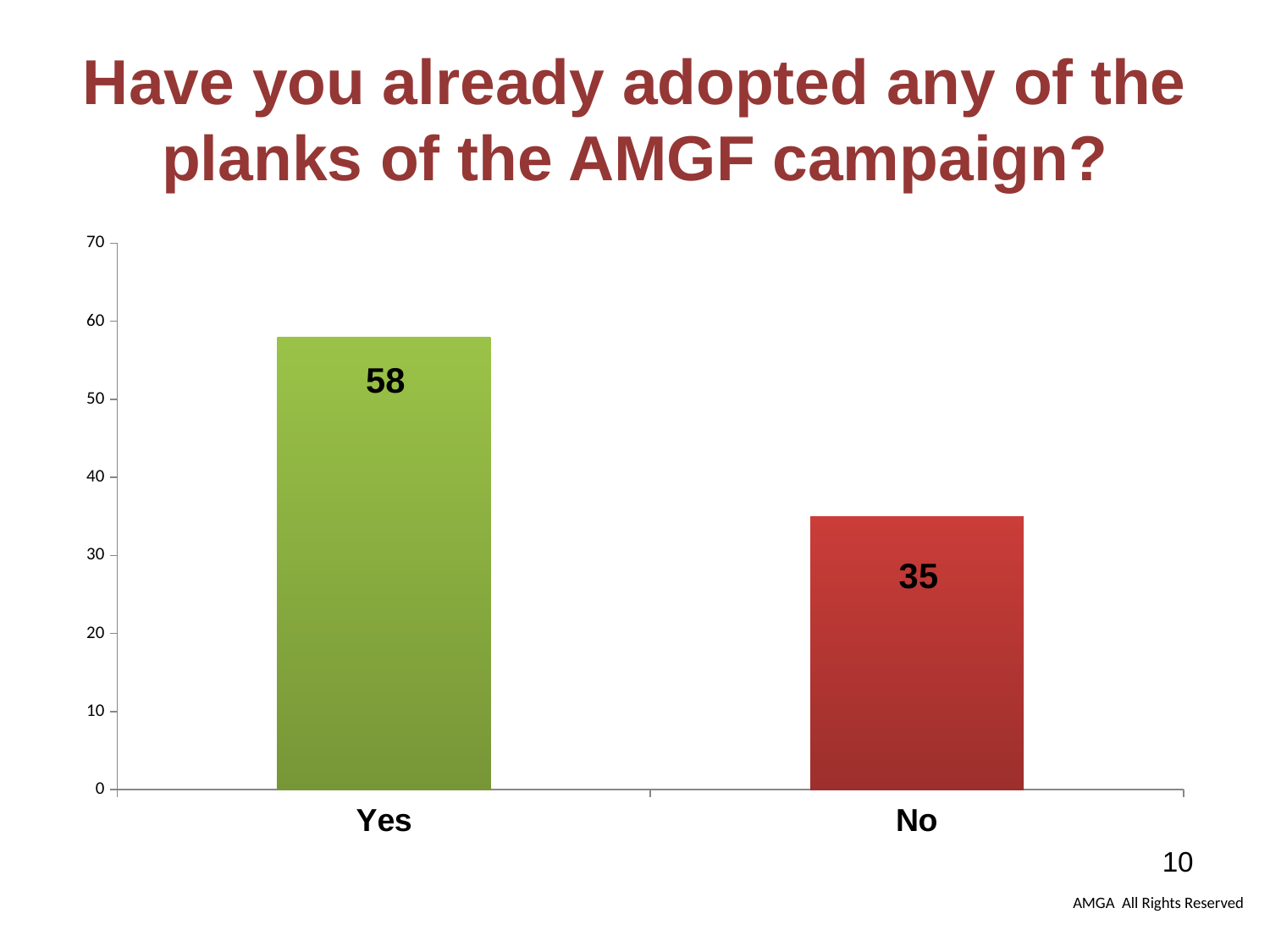
Which category has the highest value? Yes Is the value for Yes greater or less than 50? greater How many categories are shown on the x axis? 2 Is the value for No greater or less than 40? less What is the value for Yes? 58 What is the difference between the values for Yes and No? 23 What is the value for No? 35 Which category has the lowest value? No What is the title of the slide? Have you already adopted any of the planks of the AMGF campaign? What kind of chart is shown on the slide? bar chart Which is larger, the value for Yes or the value for No? Yes What colour is the bar for No? red